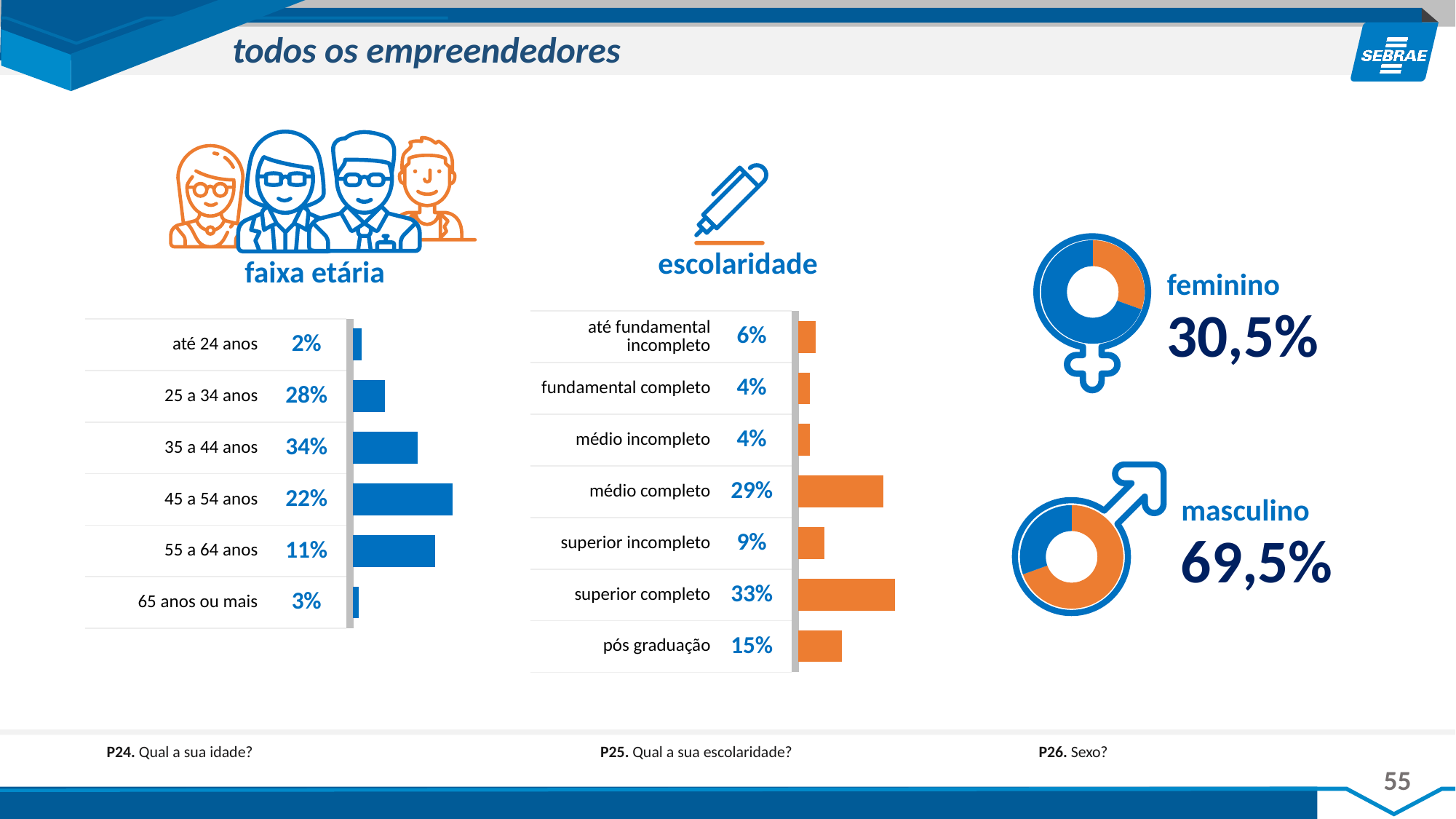
In the gender charts on the right, which is larger, 'feminino' or 'masculino'? masculino In the 'faixa etária' chart, how many age categories are shown? 6 In the 'escolaridade' chart, which category has the highest value? superior completo In the 'faixa etária' chart, what is the value for '55 a 64 anos'? 11% What type of chart is the 'escolaridade' chart? Bar chart In the 'faixa etária' chart, what is the difference between the values for '25 a 34 anos' and '45 a 54 anos'? 6 percentage points In the 'escolaridade' chart, what is the difference between 'superior completo' and 'médio completo'? 4 percentage points In the 'escolaridade' chart, how many categories are shown? 7 In the 'faixa etária' chart, what is the value for '35 a 44 anos'? 34% In the gender charts on the right, what is the share for 'feminino'? 30,5% In the 'escolaridade' chart, what is the value for 'médio completo'? 29% In the 'escolaridade' chart, what is the value for 'pós graduação'? 15%